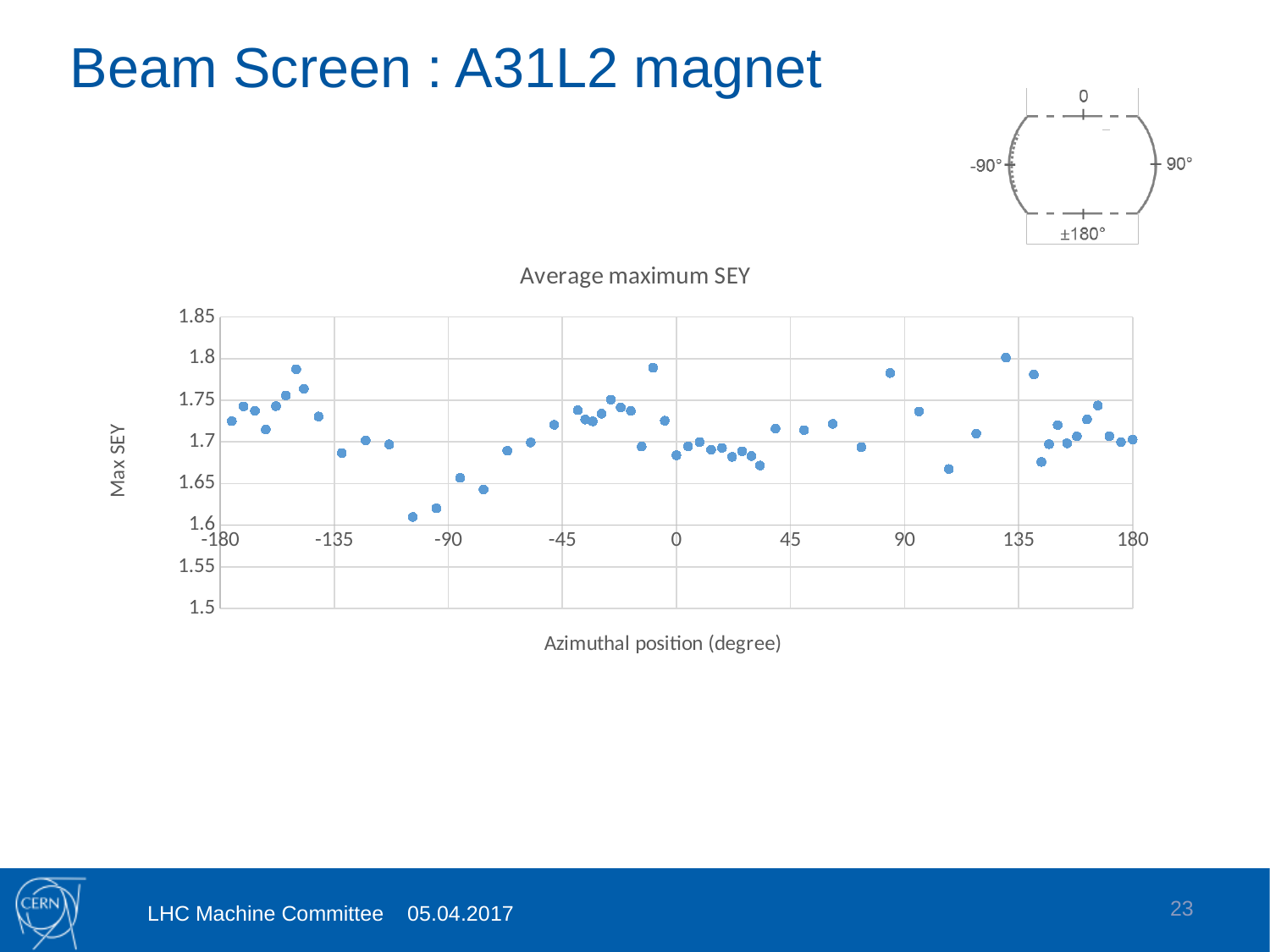
What is the label of the x axis of the chart? Azimuthal position (degree) Is the highest plotted Max SEY value greater or less than 1.75? greater What is the title of the chart? Average maximum SEY Is the Max SEY value plotted at an azimuthal position of about 85 degrees greater or less than 1.75? greater What kind of chart is shown on the slide? Scatter chart Is the Max SEY value plotted at an azimuthal position of about -105 degrees greater or less than 1.65? less Which is larger: the Max SEY value plotted at about -105 degrees or the one plotted at about 130 degrees? The one at about 130 degrees What is the maximum value shown on the y axis of the chart? 1.85 Which is larger: the Max SEY value plotted at about 85 degrees or the one plotted at about 105 degrees? The one at about 85 degrees